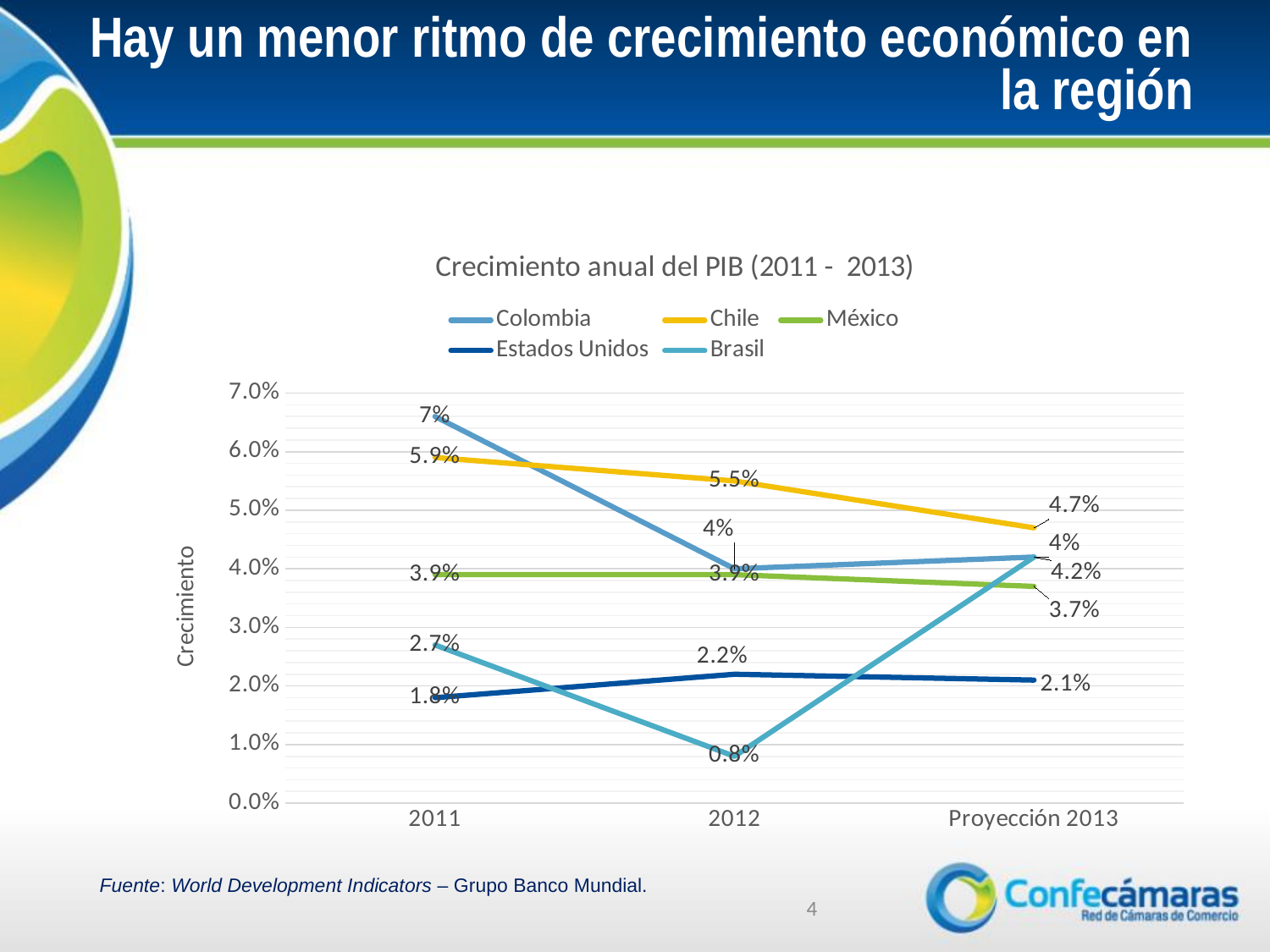
How many series does the legend list? 5 What is the value for Chile in 2011? 5.9% What is the difference between Chile's value in 2011 and in Proyección 2013? 1.2 percentage points Does the value for Chile rise or fall from 2011 to Proyección 2013? Fall What kind of chart is shown on the slide? Line chart Which country has the highest value in 2011? Colombia What is the value for México in Proyección 2013? 3.7% Which is larger in 2012, the value for Chile or the value for México? Chile How many points are shown along the x axis? 3 What is the value for Estados Unidos in 2012? 2.2% Which country has the lowest value in 2012? Brasil What is the value for Brasil in 2012? 0.8%